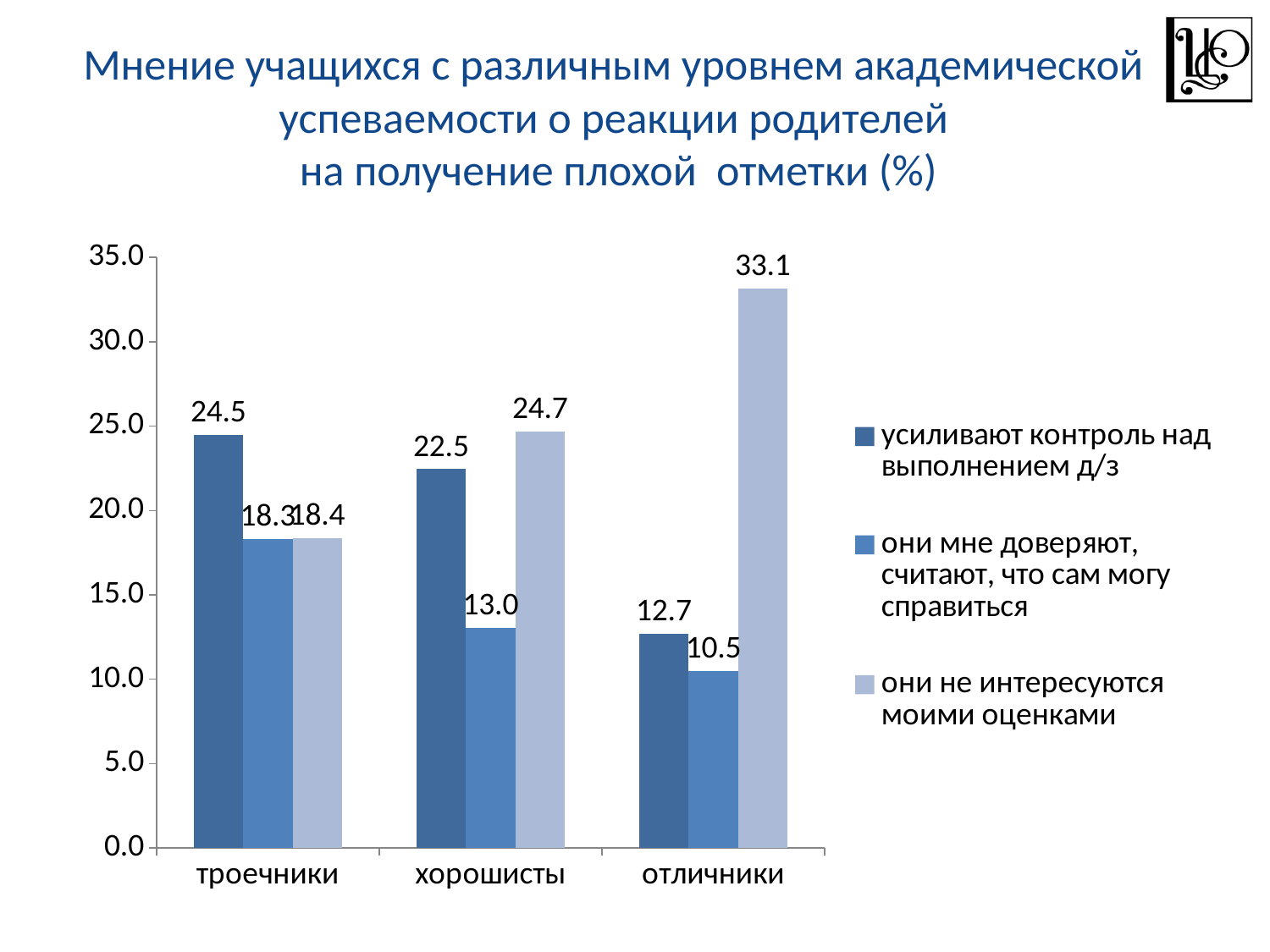
Is the value for отличники in the series 'они не интересуются моими оценками' greater or less than 30.0? greater What is the value for хорошисты in the series 'усиливают контроль над выполнением д/з'? 22.5 What is the value for отличники in the series 'они не интересуются моими оценками'? 33.1 What kind of chart is shown on the slide? bar chart How many series does the legend list? 3 How many categories are shown on the x axis? 3 Which category has the highest value in the series 'усиливают контроль над выполнением д/з'? троечники What is the value for отличники in the series 'они мне доверяют, считают, что сам могу справиться'? 10.5 Which category has the lowest value in the series 'они мне доверяют, считают, что сам могу справиться'? отличники For хорошисты, which is larger: 'усиливают контроль над выполнением д/з' or 'они не интересуются моими оценками'? они не интересуются моими оценками Do the values in the series 'они мне доверяют, считают, что сам могу справиться' rise or fall from троечники to отличники? fall What is the difference between the 'они не интересуются моими оценками' values for отличники and хорошисты? 8.4